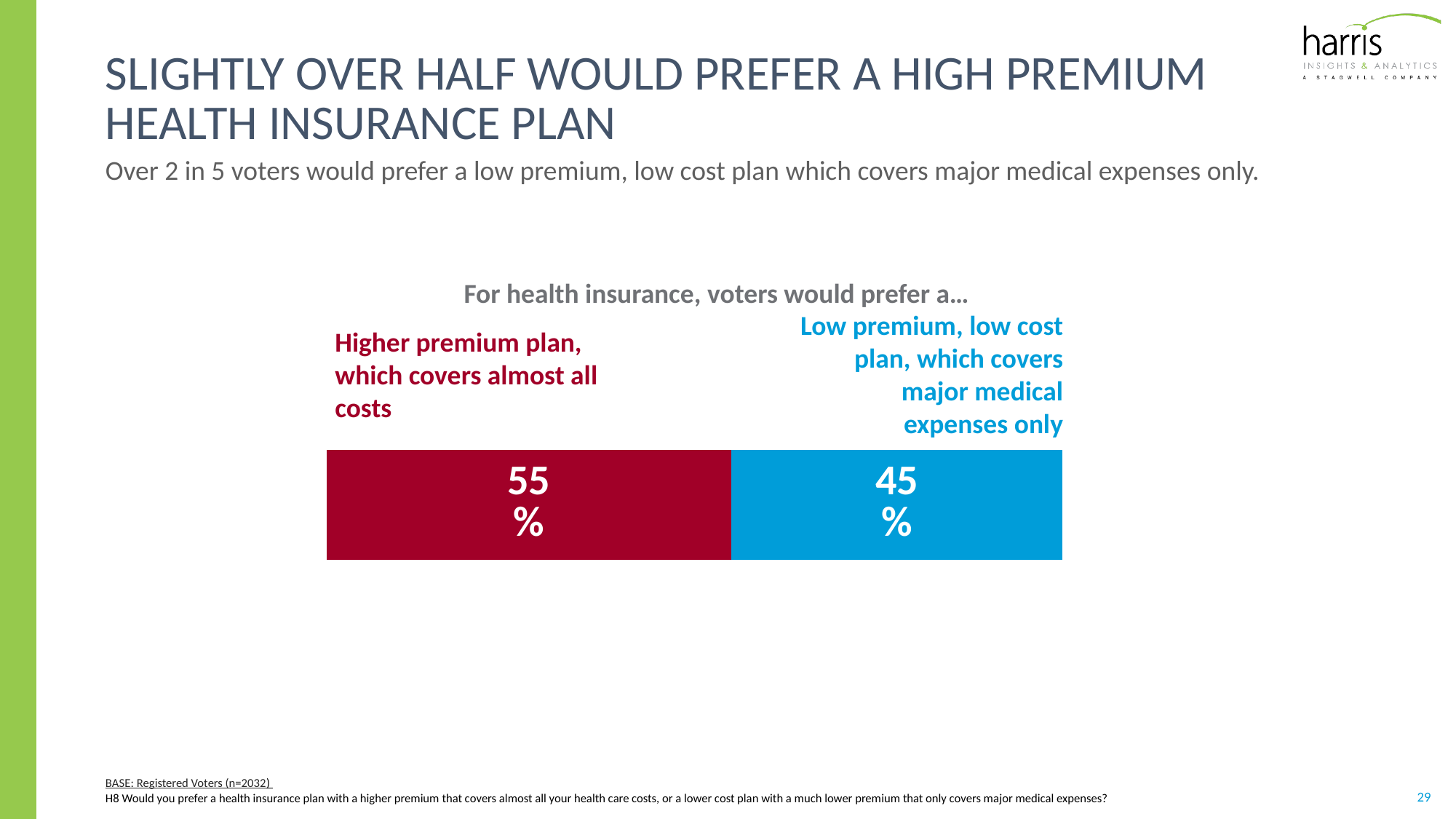
Which option has the smallest share of voters? Low premium, low cost plan, which covers major medical expenses only How many options are shown in the chart? 2 What percentage of voters would prefer a higher premium plan, which covers almost all costs? 55% Is the share of voters preferring the higher premium plan greater or less than 50%? greater What kind of chart is shown on the slide? Stacked bar chart Which option has the larger share of voters: the higher premium plan or the low premium, low cost plan? Higher premium plan, which covers almost all costs What is the title of the chart? For health insurance, voters would prefer a... What colour is the segment for the higher premium plan, which covers almost all costs? Red What percentage of voters would prefer a low premium, low cost plan, which covers major medical expenses only? 45% What is the total of the two segments in the stacked bar? 100% What is the difference in percentage points between the share preferring the higher premium plan and the share preferring the low premium, low cost plan? 10 percentage points